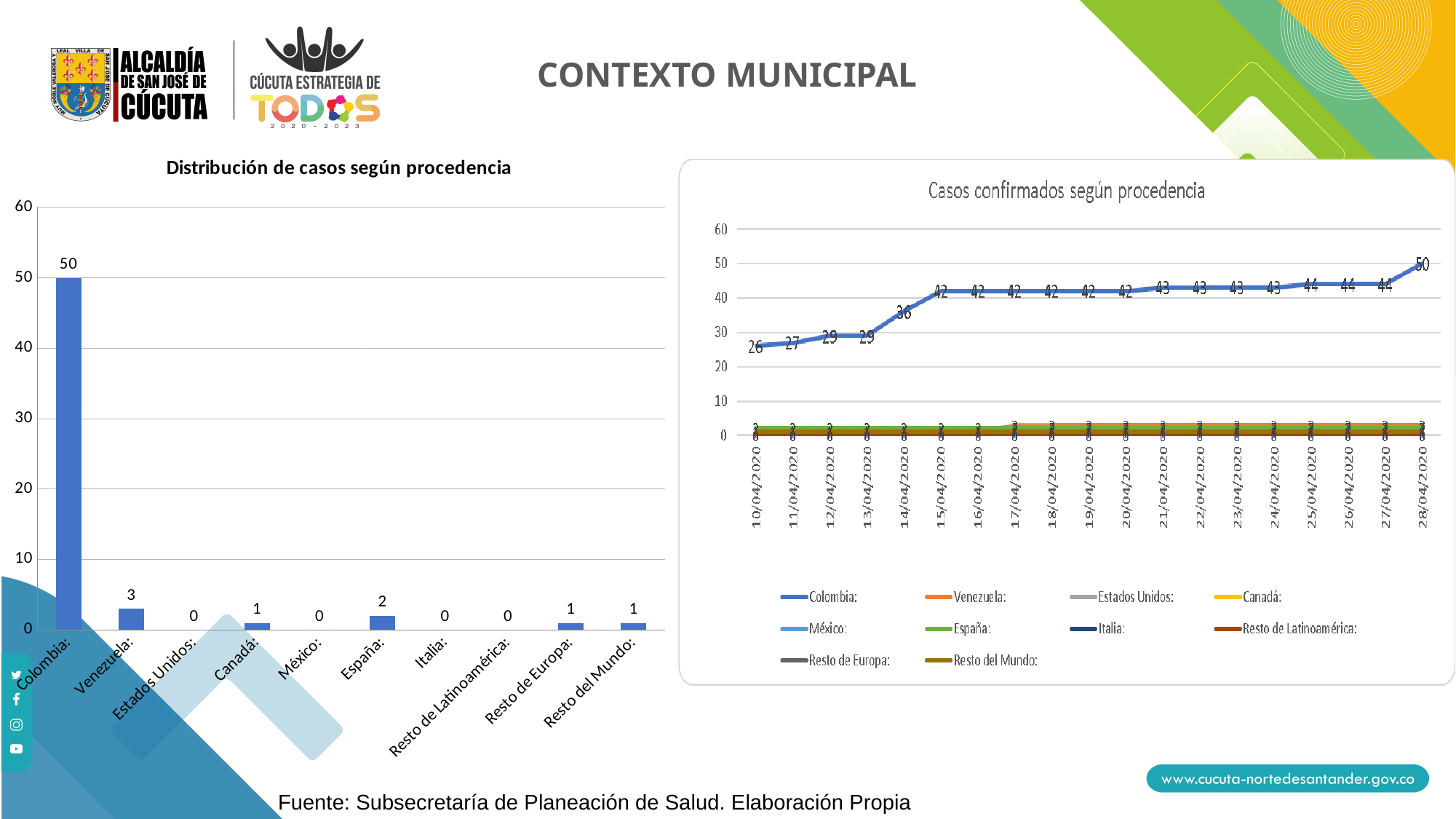
In the chart 'Casos confirmados según procedencia', what is the difference between the Colombia values on 14/04/2020 and 15/04/2020? 6 In the chart 'Distribución de casos según procedencia', which is larger, the value for España or the value for Canadá? España In the chart 'Casos confirmados según procedencia', does the Colombia series rise or fall from 10/04/2020 to 28/04/2020? Rise In the chart 'Casos confirmados según procedencia', what is the value for Colombia on 28/04/2020? 50 In the chart 'Distribución de casos según procedencia', what is the difference between the values for Colombia and Venezuela? 47 In the chart 'Distribución de casos según procedencia', what is the value for Venezuela? 3 In the chart 'Distribución de casos según procedencia', what is the value for Colombia? 50 In the chart 'Casos confirmados según procedencia', what is the value for Colombia on 10/04/2020? 26 How many series does the legend of the chart 'Casos confirmados según procedencia' list? 10 How many categories are shown in the chart 'Distribución de casos según procedencia'? 10 What kind of chart is 'Distribución de casos según procedencia'? Bar chart In the chart 'Distribución de casos según procedencia', which category has the highest value? Colombia